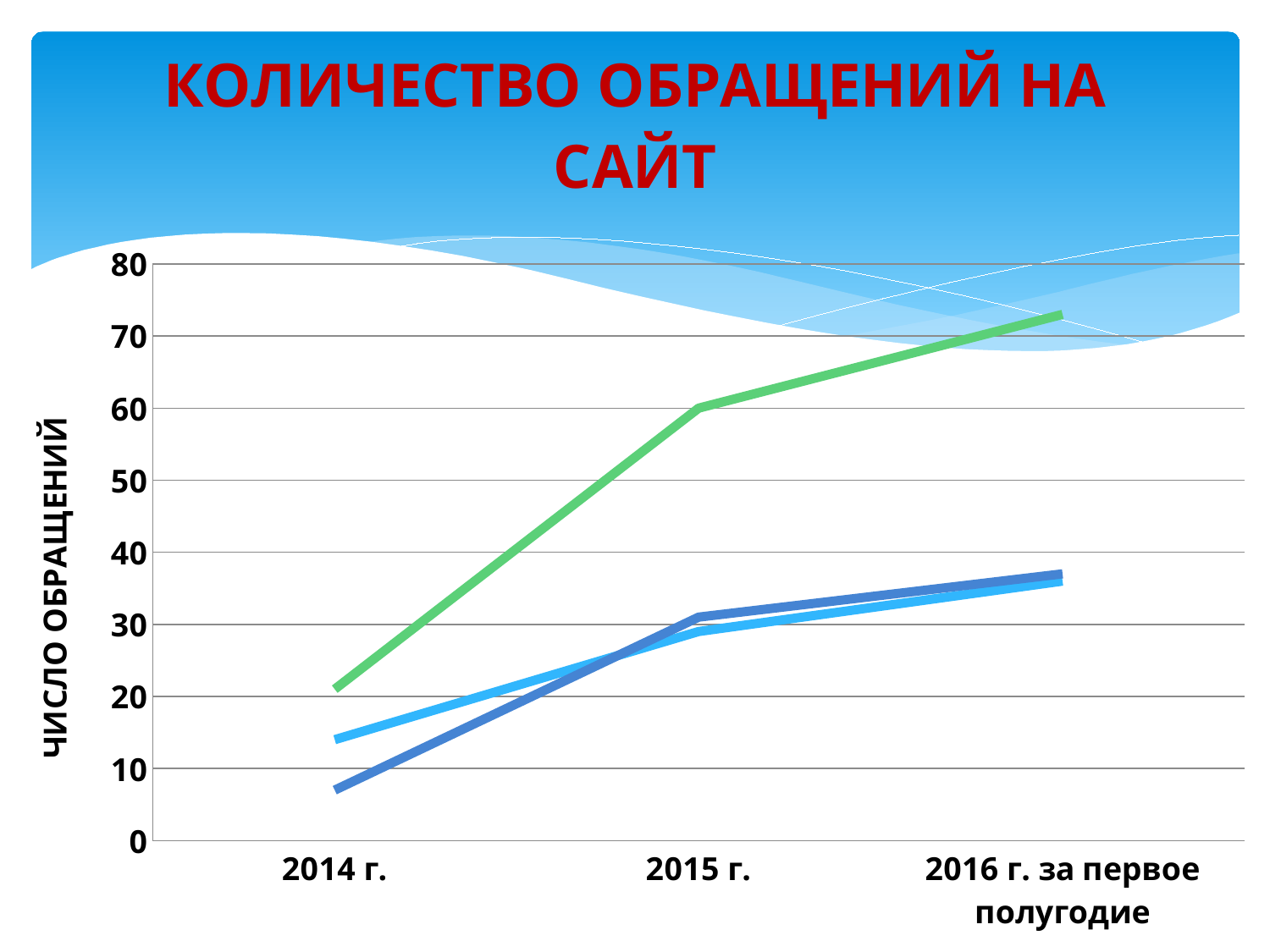
In 2015 г., is the value of the green line larger or smaller than the value of the light blue line? larger Which line has the highest value in 2016 г. за первое полугодие? the green line How many lines are plotted on the chart? 3 Is the value of the green line for 2014 г. greater or less than 30? less Does the green line rise or fall from 2014 г. to 2016 г. за первое полугодие? rises How many categories are shown on the x axis of the chart? 3 What kind of chart is shown on the slide? line chart Is the value of the dark blue line for 2014 г. greater or less than 10? less What is the title of the chart? КОЛИЧЕСТВО ОБРАЩЕНИЙ НА САЙТ Which line has the lowest value in 2014 г.? the dark blue line Is the value of the green line for 2016 г. за первое полугодие greater or less than 70? greater What is the label on the vertical axis of the chart? ЧИСЛО ОБРАЩЕНИЙ